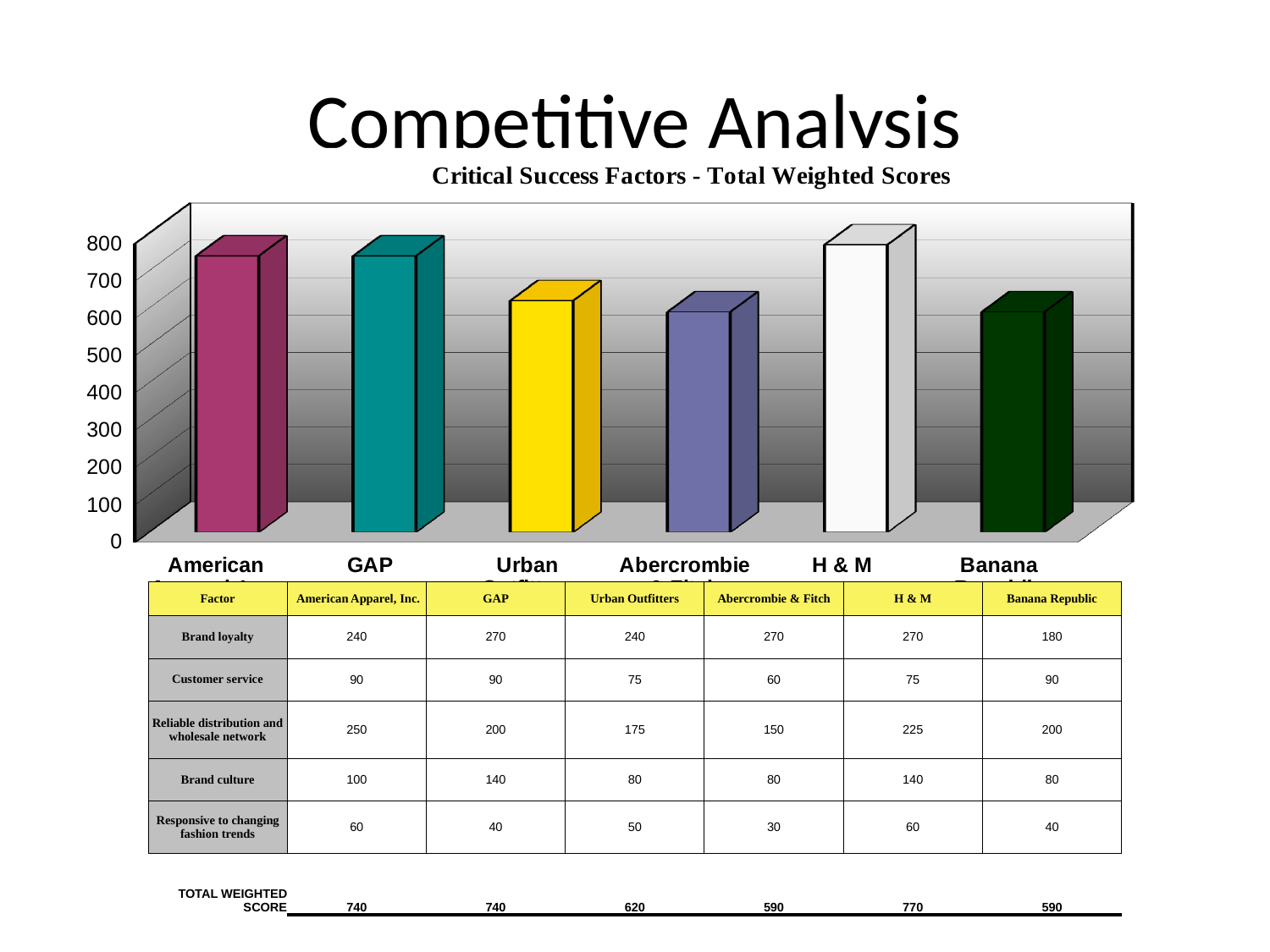
How many companies are plotted in the chart? 6 What is the total weighted score for H & M? 770 What is the title of the chart? Critical Success Factors - Total Weighted Scores What is the total weighted score for GAP? 740 Is the value for Banana Republic greater or less than 700? less What is the total weighted score for Urban Outfitters? 620 What is the difference between the total weighted scores of H & M and Urban Outfitters? 150 Is the value for H & M greater or less than 700? greater Which company has the highest total weighted score in the chart? H & M Which is larger, the total weighted score for GAP or for Urban Outfitters? GAP What is the total weighted score for Abercrombie & Fitch? 590 What type of chart is shown on the slide? bar chart